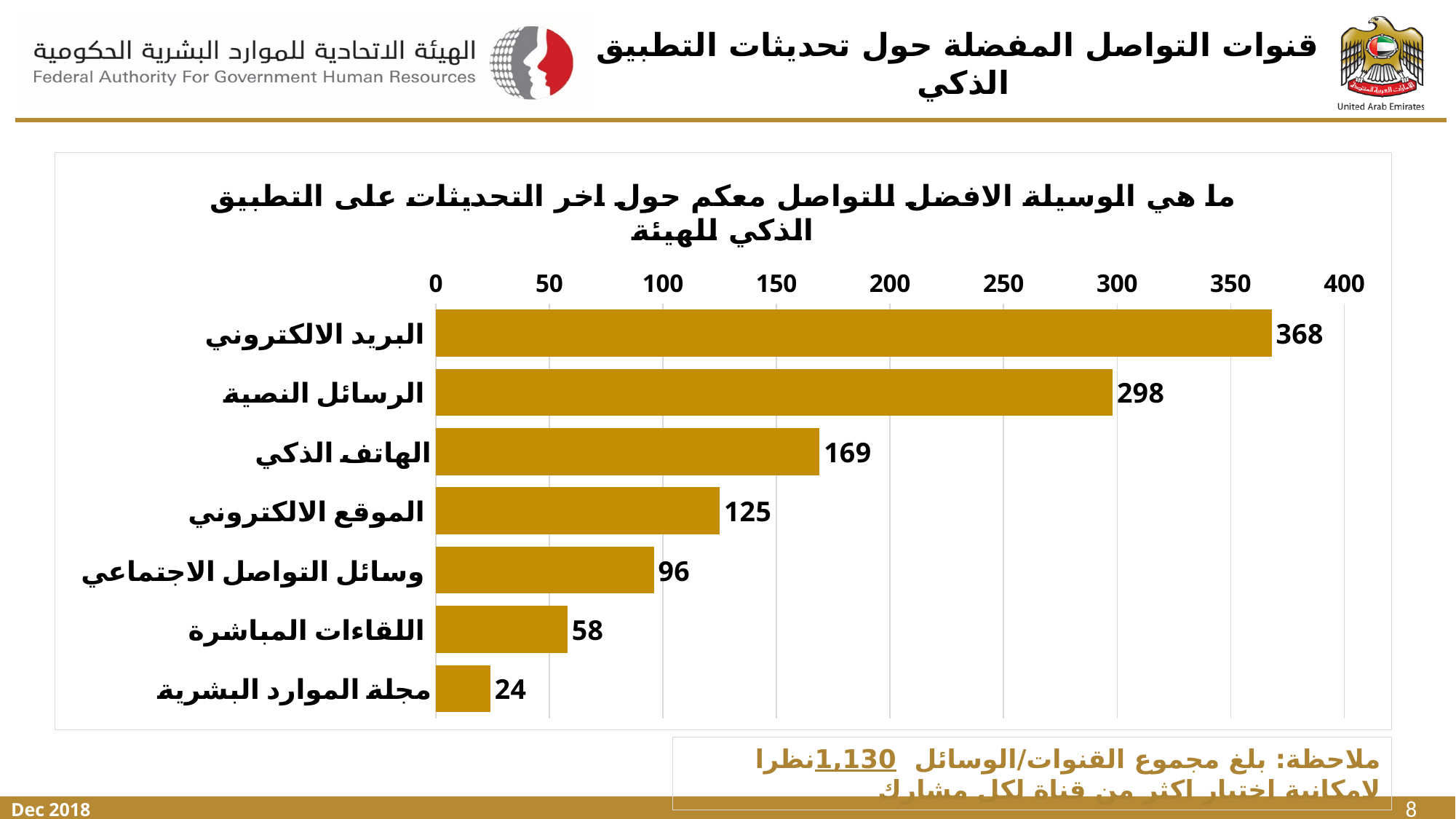
What is the difference between the values for الهاتف الذكي and الموقع الالكتروني? 44 What is the value for الرسائل النصية (text messages)? 298 Which category has the highest value? البريد الالكتروني What is the value for وسائل التواصل الاجتماعي (social media)? 96 What is the value for مجلة الموارد البشرية (HR magazine)? 24 What is the value for البريد الالكتروني (email)? 368 Which is larger, the value for اللقاءات المباشرة or the value for وسائل التواصل الاجتماعي? وسائل التواصل الاجتماعي Which category has the lowest value? مجلة الموارد البشرية Is the value for الهاتف الذكي greater or less than 150? greater What is the difference between the values for البريد الالكتروني and الرسائل النصية? 70 How many categories are shown in the chart? 7 What kind of chart is shown on the slide? bar chart